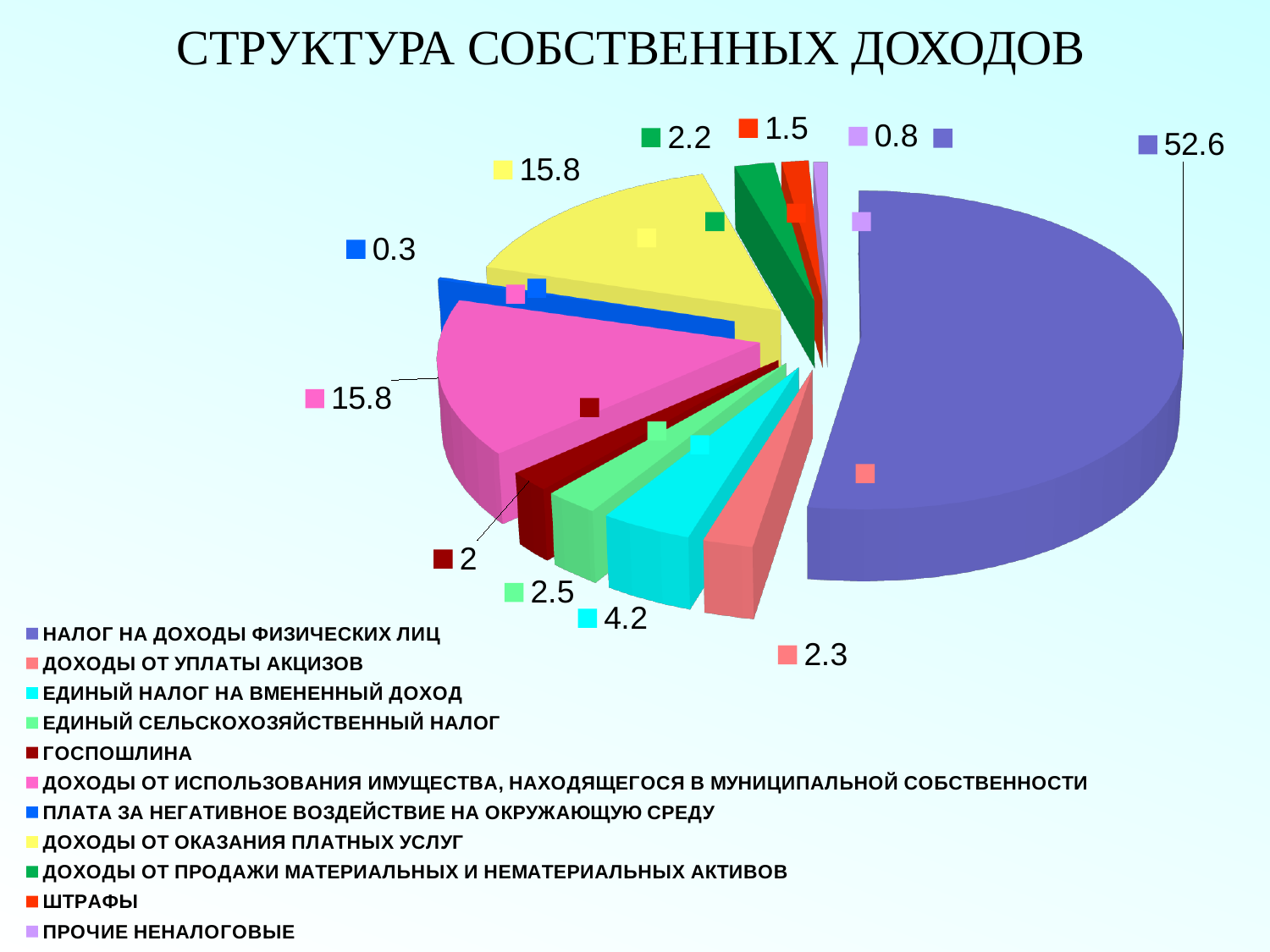
Which is larger, the value for ЕДИНЫЙ НАЛОГ НА ВМЕНЕННЫЙ ДОХОД or the value for ДОХОДЫ ОТ УПЛАТЫ АКЦИЗОВ? ЕДИНЫЙ НАЛОГ НА ВМЕНЕННЫЙ ДОХОД What is the value for ПРОЧИЕ НЕНАЛОГОВЫЕ? 0.8 What is the difference between the values for НАЛОГ НА ДОХОДЫ ФИЗИЧЕСКИХ ЛИЦ and ДОХОДЫ ОТ ОКАЗАНИЯ ПЛАТНЫХ УСЛУГ? 36.8 What is the value for ГОСПОШЛИНА? 2 Which category has the smallest slice? ПЛАТА ЗА НЕГАТИВНОЕ ВОЗДЕЙСТВИЕ НА ОКРУЖАЮЩУЮ СРЕДУ What is the value for НАЛОГ НА ДОХОДЫ ФИЗИЧЕСКИХ ЛИЦ? 52.6 What is the value for ШТРАФЫ? 1.5 What is the value for ЕДИНЫЙ НАЛОГ НА ВМЕНЕННЫЙ ДОХОД? 4.2 Which category has the largest slice? НАЛОГ НА ДОХОДЫ ФИЗИЧЕСКИХ ЛИЦ What is the title of the chart? СТРУКТУРА СОБСТВЕННЫХ ДОХОДОВ What type of chart is shown on the slide? pie chart How many categories does the legend list? 11